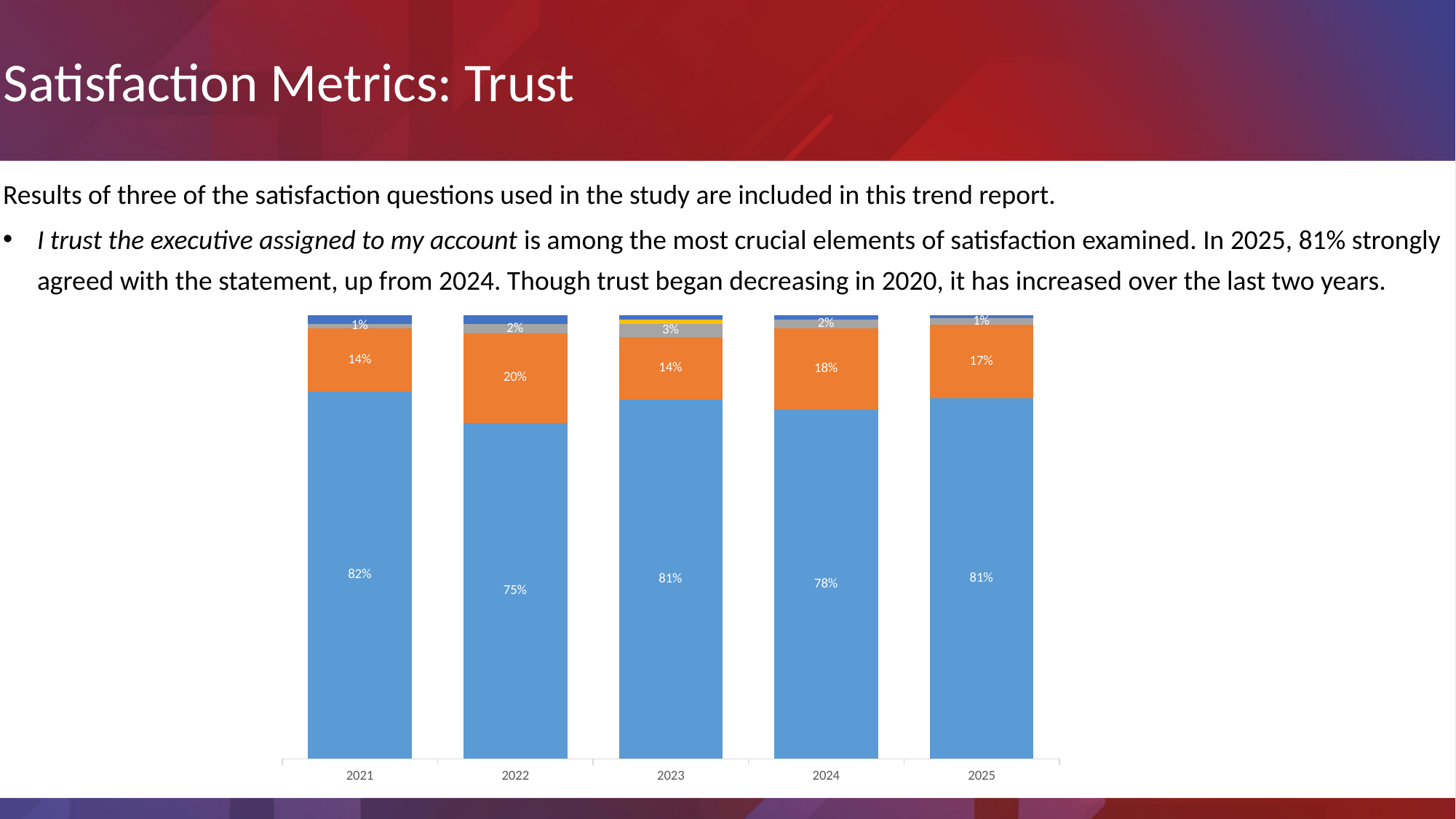
How many years are shown on the x axis of the chart? 5 What is the value of the orange segment of the bar for 2022? 20% Which year has the largest orange segment? 2022 Does the bottom (blue) segment rise or fall from 2024 to 2025? Rise What is the value of the bottom (blue) segment of the bar for 2021? 82% Which year has the lowest value for the bottom (blue) segment? 2022 Is the orange segment larger in 2024 or in 2025? 2024 What is the value of the gray segment of the bar for 2023? 3% What is the difference between the bottom (blue) segment values for 2021 and 2022? 7 percentage points Which year has the highest value for the bottom (blue) segment? 2021 What is the value of the bottom (blue) segment of the bar for 2024? 78% What kind of chart is shown on the slide? Stacked bar chart